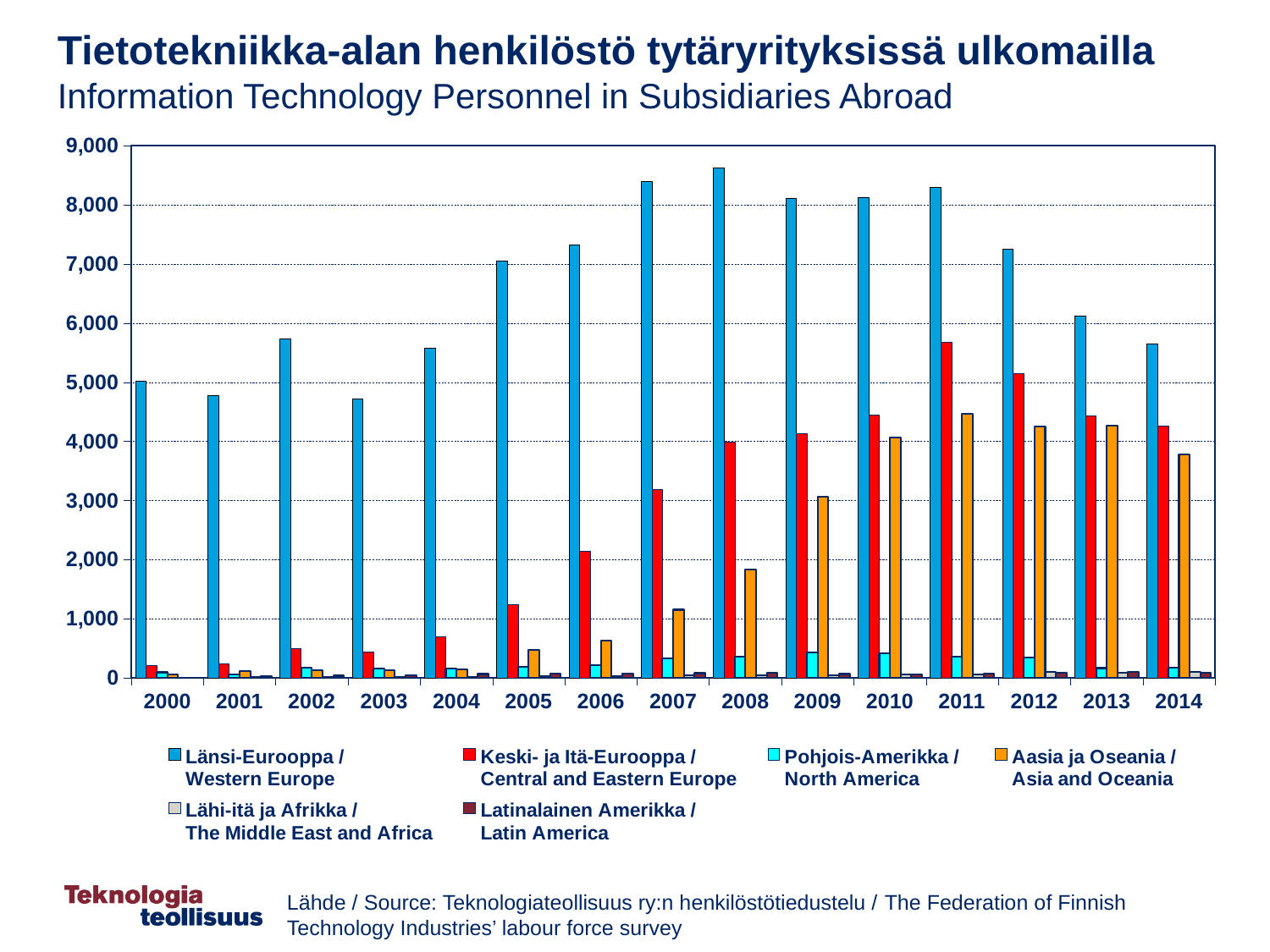
Is the value for Central and Eastern Europe in 2007 greater or less than 3,000? greater How many years are shown on the x axis? 15 Do the values for Central and Eastern Europe rise or fall from 2000 to 2011? rise How many series does the legend list? 6 In which year is the value for Central and Eastern Europe highest? 2011 Is the value for Asia and Oceania in 2011 greater or less than 4,000? greater In 2011, which is larger: Central and Eastern Europe or Asia and Oceania? Central and Eastern Europe What kind of chart is shown on the slide? bar chart Is the value for Western Europe in 2008 greater or less than 8,000? greater In 2014, which is larger: Western Europe or Central and Eastern Europe? Western Europe In which year is the value for Western Europe highest? 2008